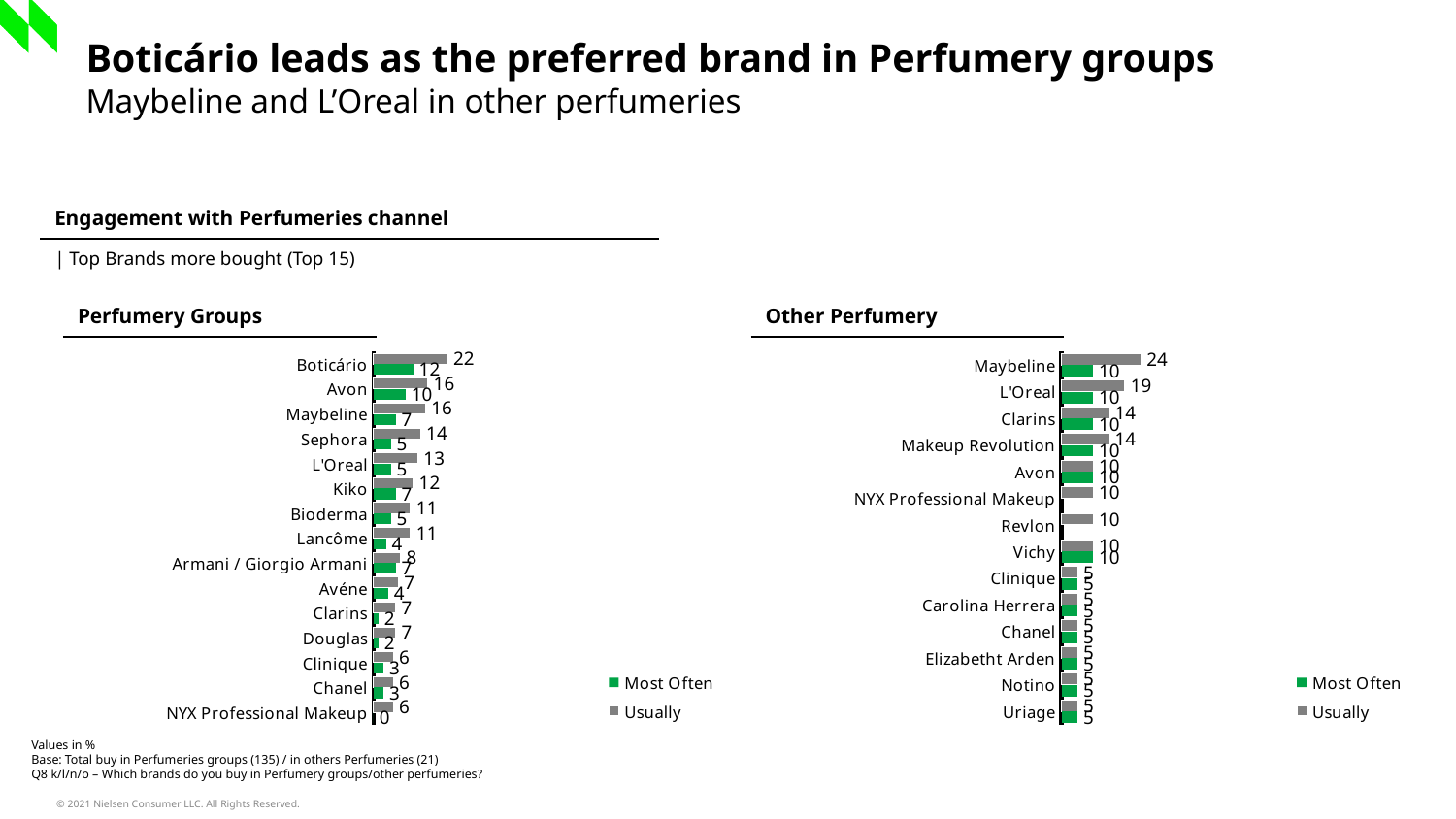
In the Other Perfumery chart, what is the Usually value for Maybeline? 24 In the Perfumery Groups chart, which brand has the highest Usually value? Boticário In the Other Perfumery chart, what is the difference between the Usually values for Maybeline and L'Oreal? 5 What type of chart is the Perfumery Groups chart? Bar chart In the Other Perfumery chart, what is the Most Often value for L'Oreal? 10 In the Perfumery Groups chart, what is the Usually value for Boticário? 22 How many brands are listed in the Perfumery Groups chart? 15 How many series does the legend of the Other Perfumery chart list? 2 In the Perfumery Groups chart, which is larger: the Most Often value for Avon or for Sephora? Avon In the Perfumery Groups chart, what is the Most Often value for Boticário? 12 In the Other Perfumery chart, which brand has the highest Usually value? Maybeline In the Perfumery Groups chart, what is the difference between the Usually values for Boticário and Avon? 6